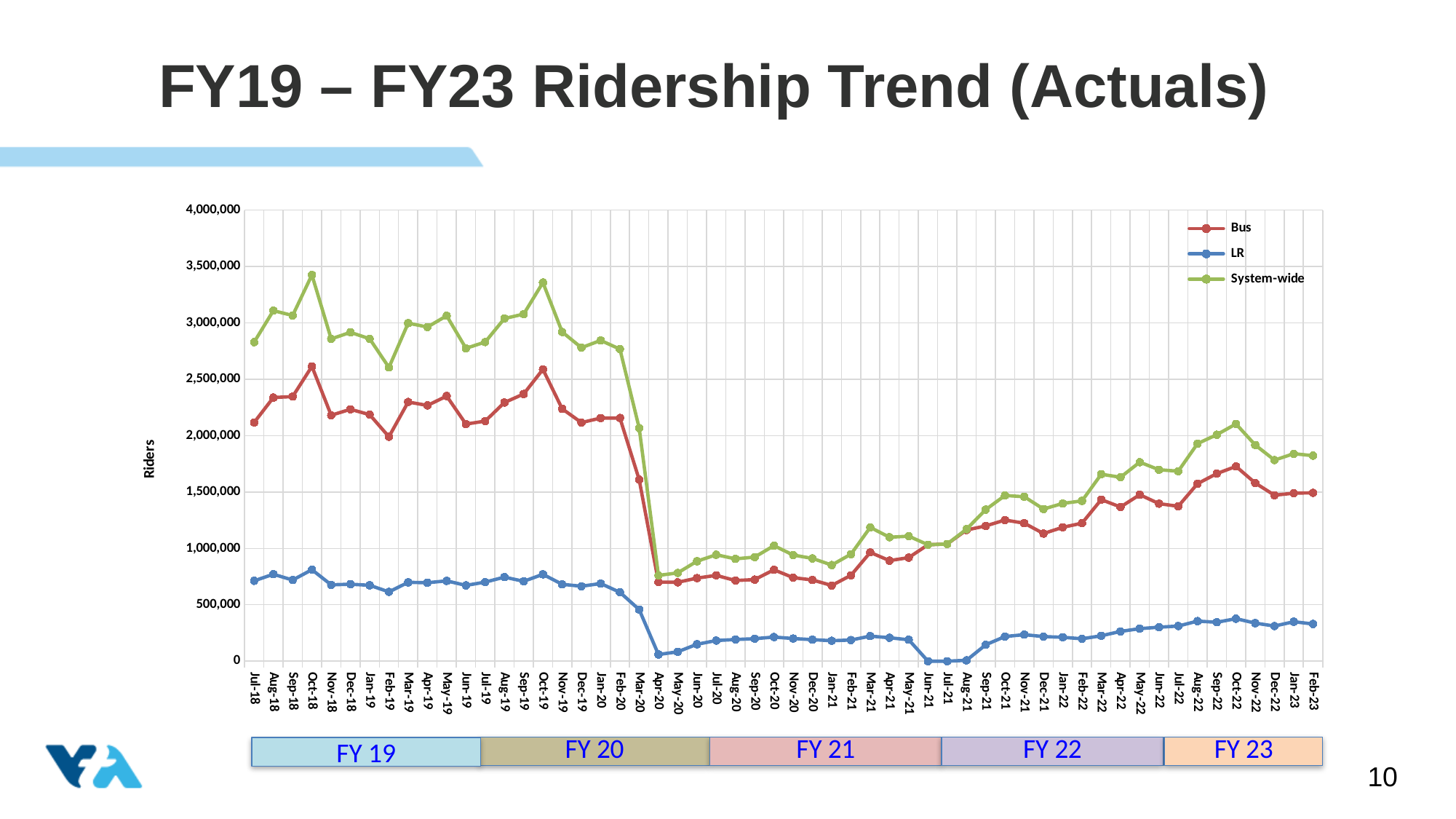
How many series does the legend list? 3 What kind of chart is shown on the slide? Line chart Which month has the lowest System-wide value? Apr-20 Is the LR value for Apr-20 greater or less than 500,000? less Is the System-wide value for Oct-22 greater or less than 2,000,000? greater What are the three series named in the legend? Bus, LR, System-wide What is the label on the vertical axis? Riders Which is larger in Jul-18, the Bus value or the LR value? Bus Does the System-wide line rise or fall between Feb-20 and Apr-20? Fall Which is larger for System-wide, the value in Oct-18 or the value in Oct-22? Oct-18 Is the Bus value for Apr-20 greater or less than 1,000,000? less